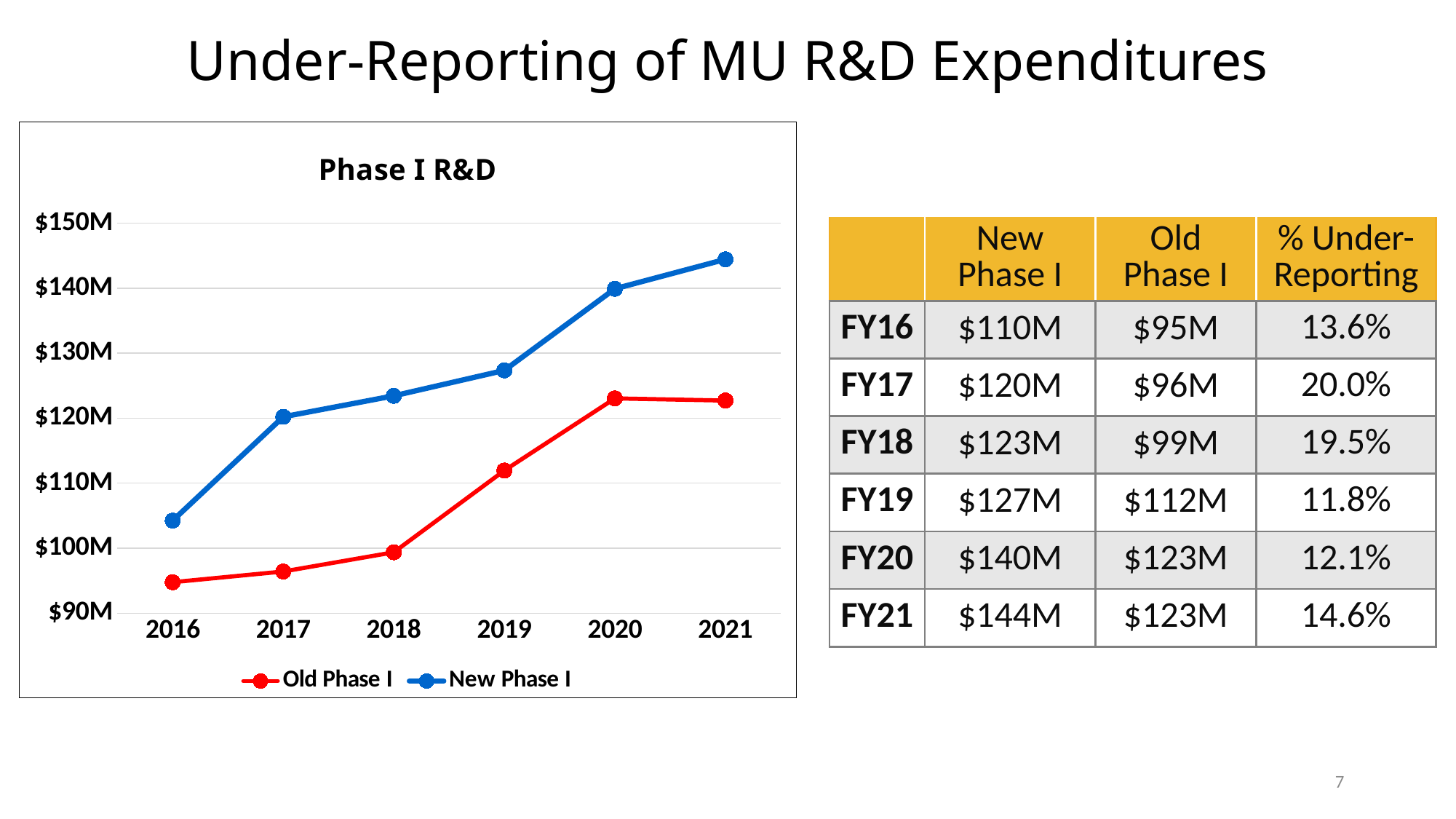
How many years are plotted along the x axis of the Phase I R&D chart? 6 In the Phase I R&D chart, which series has the larger value in 2021, Old Phase I or New Phase I? New Phase I In the Phase I R&D chart, is the New Phase I value for 2018 greater or less than $120M? greater What colour is the Old Phase I line in the Phase I R&D chart? red What kind of chart is the Phase I R&D chart? line chart In the Phase I R&D chart, is the New Phase I value for 2020 greater or less than $130M? greater In the Phase I R&D chart, which year has the lowest Old Phase I value? 2016 In the Phase I R&D chart, which year has the highest New Phase I value? 2021 How many series does the legend of the Phase I R&D chart list? 2 In the Phase I R&D chart, is the Old Phase I value for 2019 greater or less than $100M? greater In the Phase I R&D chart, does the New Phase I series rise or fall from 2016 to 2021? rises